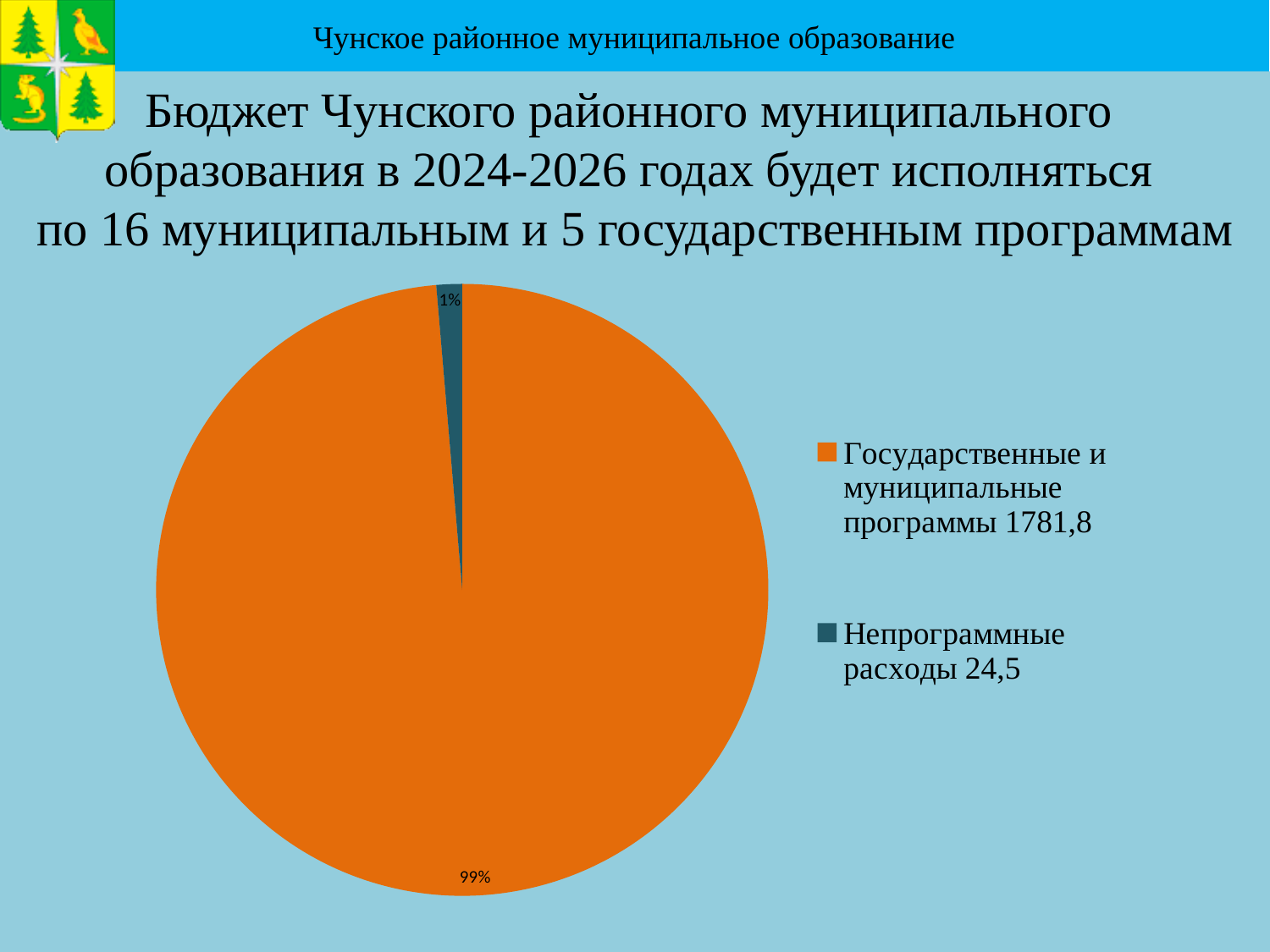
What colour is the slice for Непрограммные расходы? dark teal What share of the pie does the slice for Непрограммные расходы represent? 1% How many entries does the legend of the pie chart list? 2 What kind of chart is shown on the slide? pie chart What value is given in the legend for Непрограммные расходы? 24,5 Which slice of the pie chart is the smallest? Непрограммные расходы Which slice of the pie chart is the largest? Государственные и муниципальные программы Which is larger: Государственные и муниципальные программы or Непрограммные расходы? Государственные и муниципальные программы What is the difference between the values for Государственные и муниципальные программы (1781,8) and Непрограммные расходы (24,5)? 1757,3 What share of the pie does the slice for Государственные и муниципальные программы represent? 99% How many slices does the pie chart have? 2 What value is given in the legend for Государственные и муниципальные программы? 1781,8